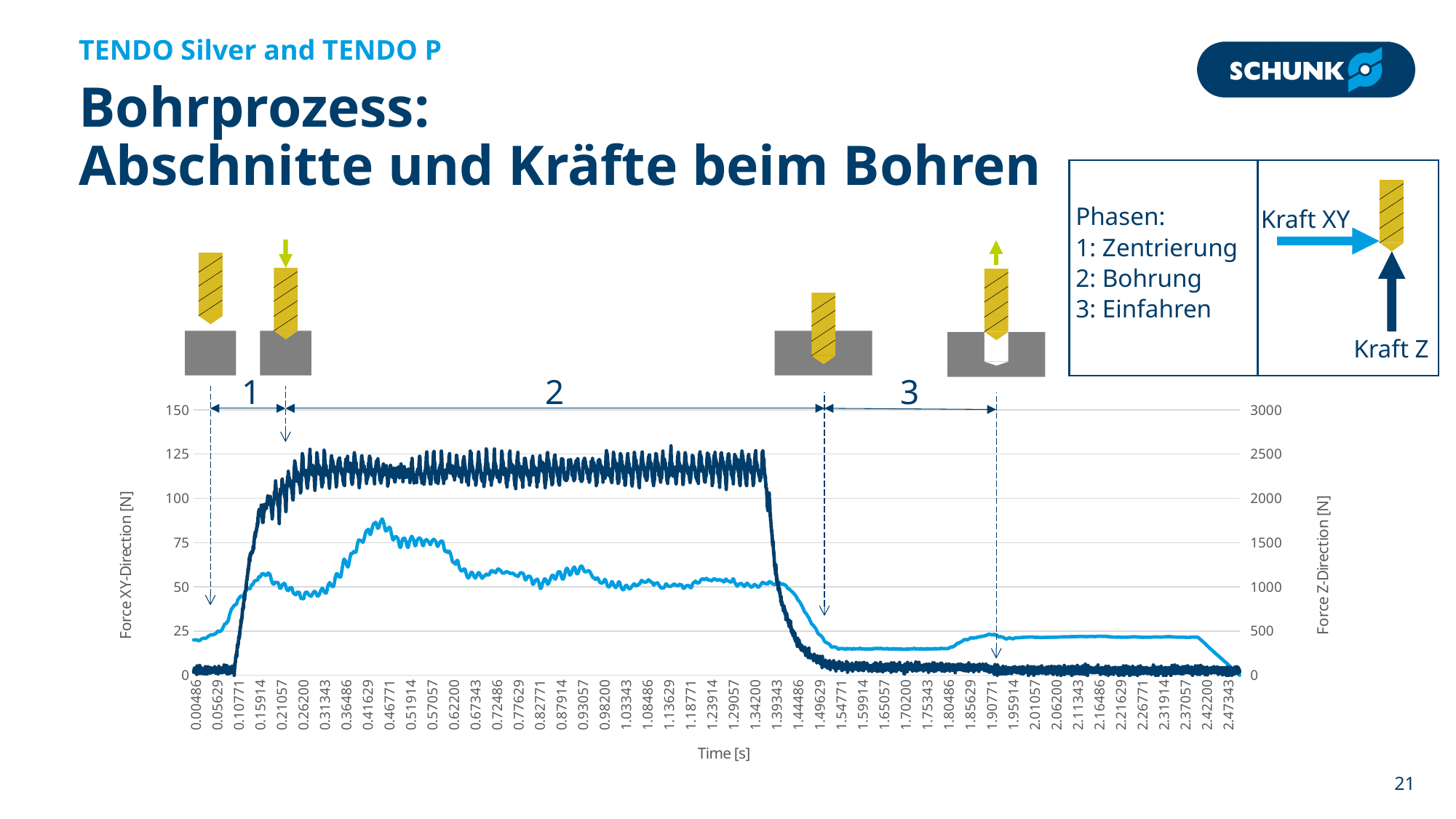
During phase 2, is the dark blue line above or below the 100 gridline of the left axis? above What is the highest tick value shown on the left y axis (Force XY-Direction [N])? 150 What is the label of the x axis of the chart? Time [s] How many phases are marked above the chart? 3 Does the light blue line rise or fall between time 0.05629 and 0.15914? rise Does the dark blue line rise or fall between time 1.34200 and 1.44486? fall After time 1.54771, is the dark blue line above or below the 25 gridline of the left axis? below At its peak around time 0.46771, is the light blue line above or below the 75 gridline of the left axis? above What kind of chart is shown on the slide? line chart What is the label of the left y axis of the chart? Force XY-Direction [N] What is the highest tick value shown on the right y axis (Force Z-Direction [N])? 3000